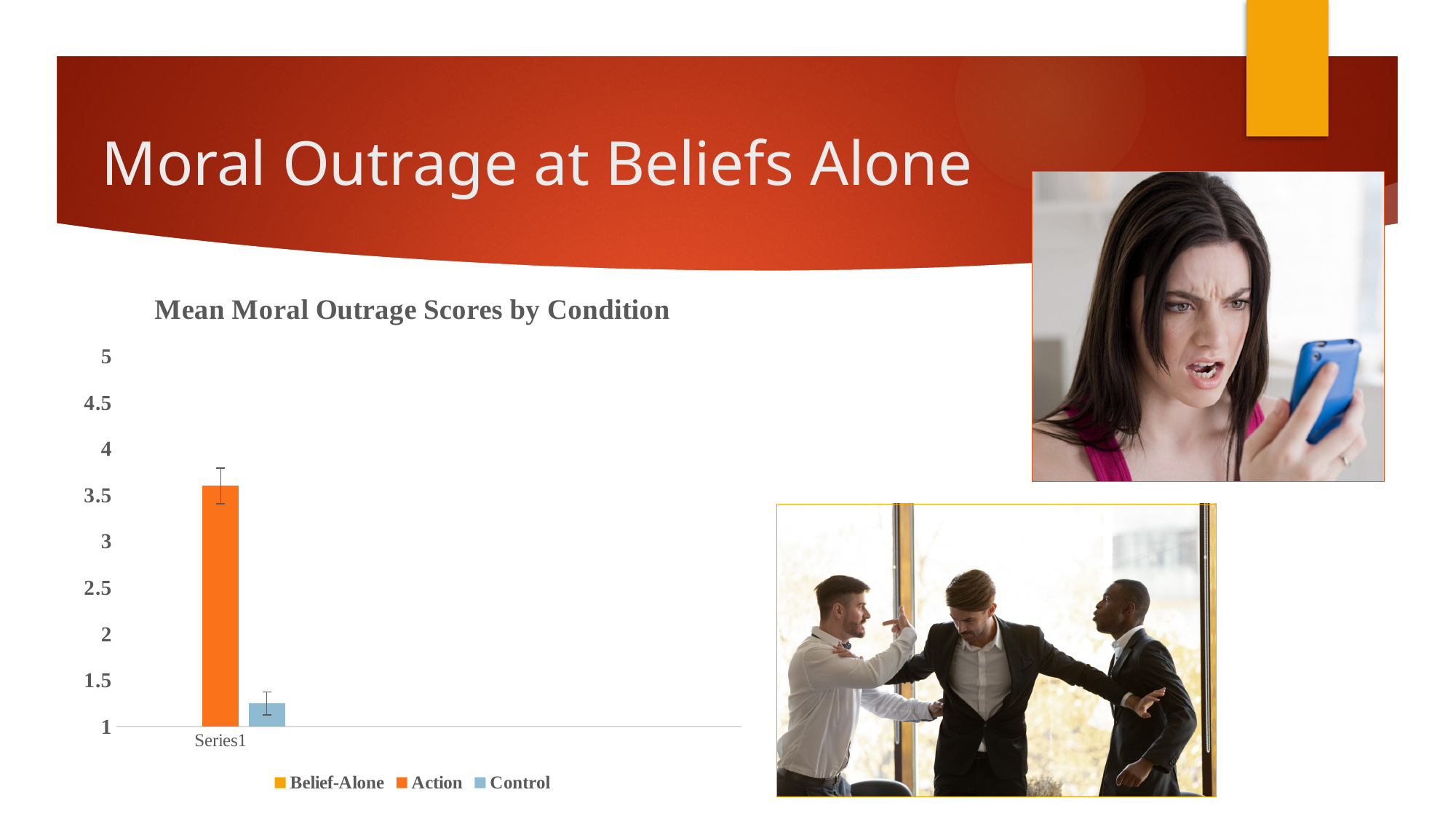
Is the value for Action greater or less than 4? less What is the title of the chart? Mean Moral Outrage Scores by Condition How many series does the chart legend list? 3 Which series in the legend is shown in light blue? Control Which of the plotted bars is the tallest? Action Is the value for Control greater or less than 1.5? less Is the value for Control greater or less than 2? less What is the highest value shown on the vertical axis? 5 What kind of chart is shown on the slide? bar chart Which of the plotted bars is the shortest? Control Which is larger, the value for Action or the value for Control? Action